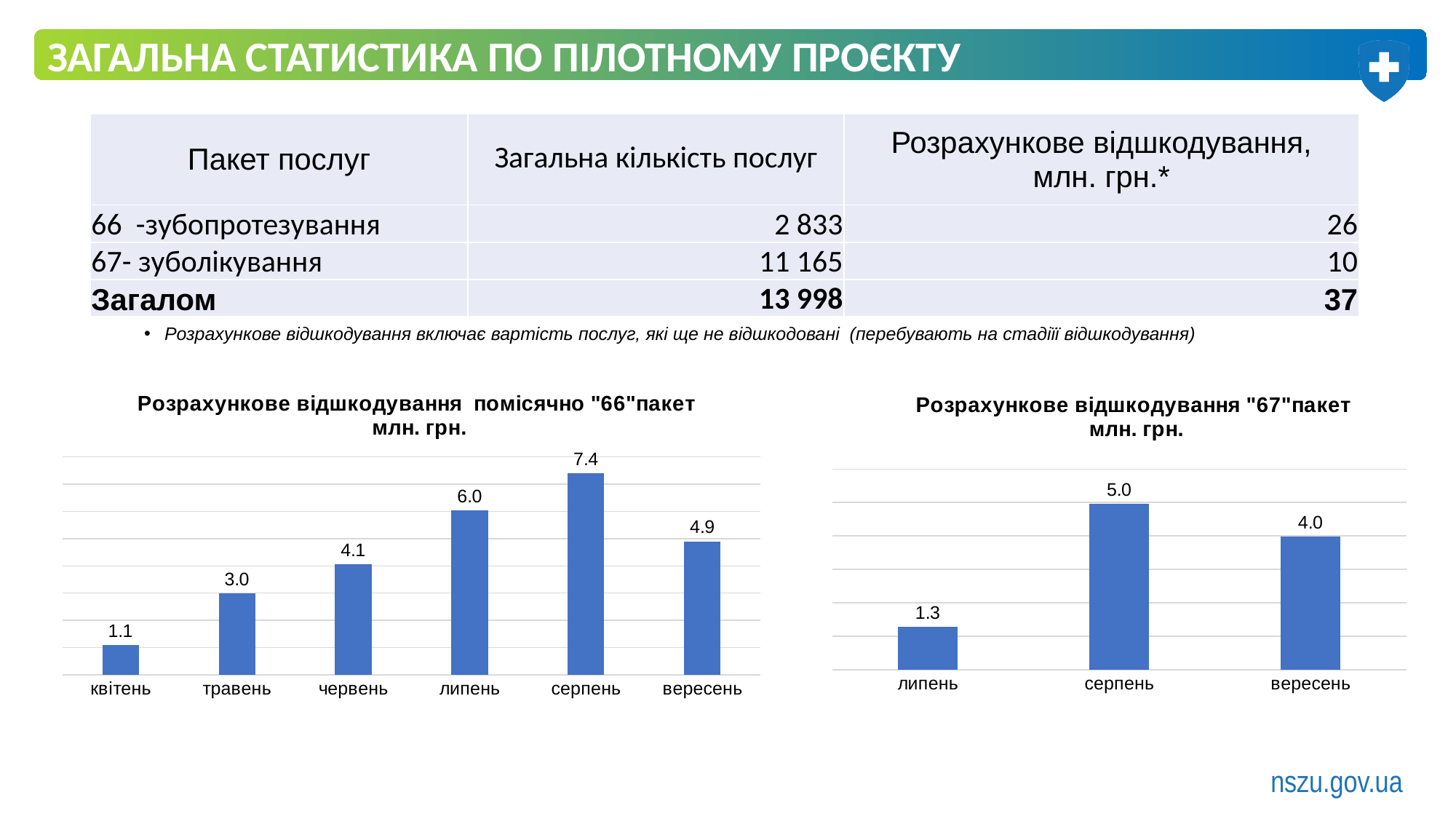
In the right chart ("67" package), what is the value for липень? 1.3 In the left chart ("66" package), what is the value for квітень? 1.1 In the right chart ("67" package), what is the difference between the values for серпень and липень? 3.7 In the left chart ("66" package), what is the difference between the values for серпень and вересень? 2.5 How many months are shown in the left chart ("66" package)? 6 In the left chart ("66" package), which is larger, the value for липень or the value for червень? липень In the left chart ("66" package), which month has the highest value? серпень How many months are shown in the right chart ("67" package)? 3 In the right chart ("67" package), which month has the highest value? серпень What type of chart is the right chart ("67" package)? bar chart In the left chart ("66" package), which month has the lowest value? квітень In the left chart ("66" package), what is the value for серпень? 7.4